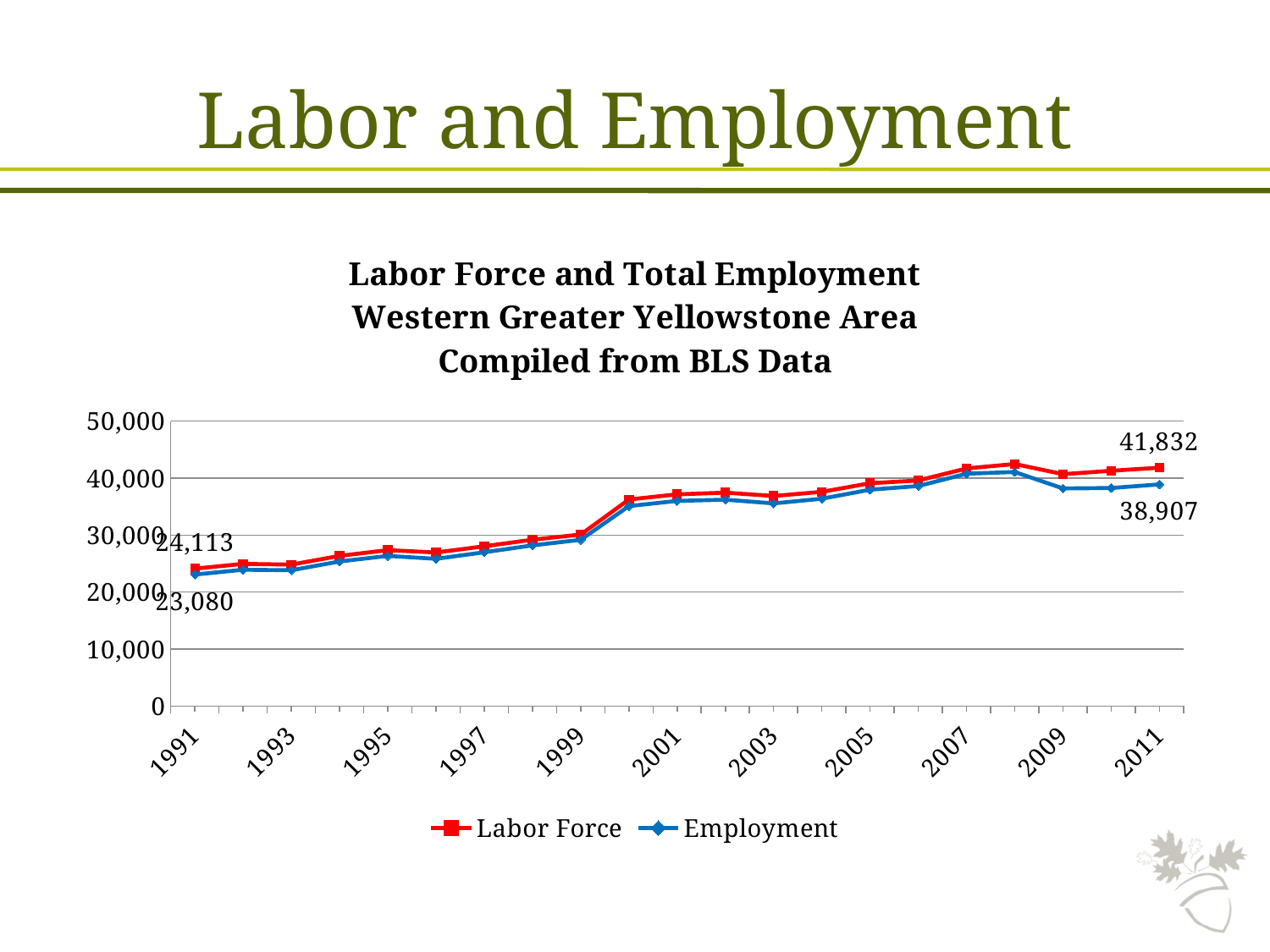
What kind of chart is shown on the slide? Line chart Is the Employment value for 2003 greater or less than 40,000? less Do the Labor Force values generally rise or fall from 1991 to 2011? Rise Which series is drawn in red? Labor Force What is the Labor Force value shown for 2011? 41,832 By how much did the Labor Force value increase from 1991 to 2011? 17,719 What is the difference between the Labor Force and Employment values in 2011? 2,925 How many series does the legend list? 2 What is the Employment value shown for 1991? 23,080 What is the Employment value shown for 2011? 38,907 What is the Labor Force value shown for 1991? 24,113 Which is larger in 2011, the Labor Force value or the Employment value? Labor Force